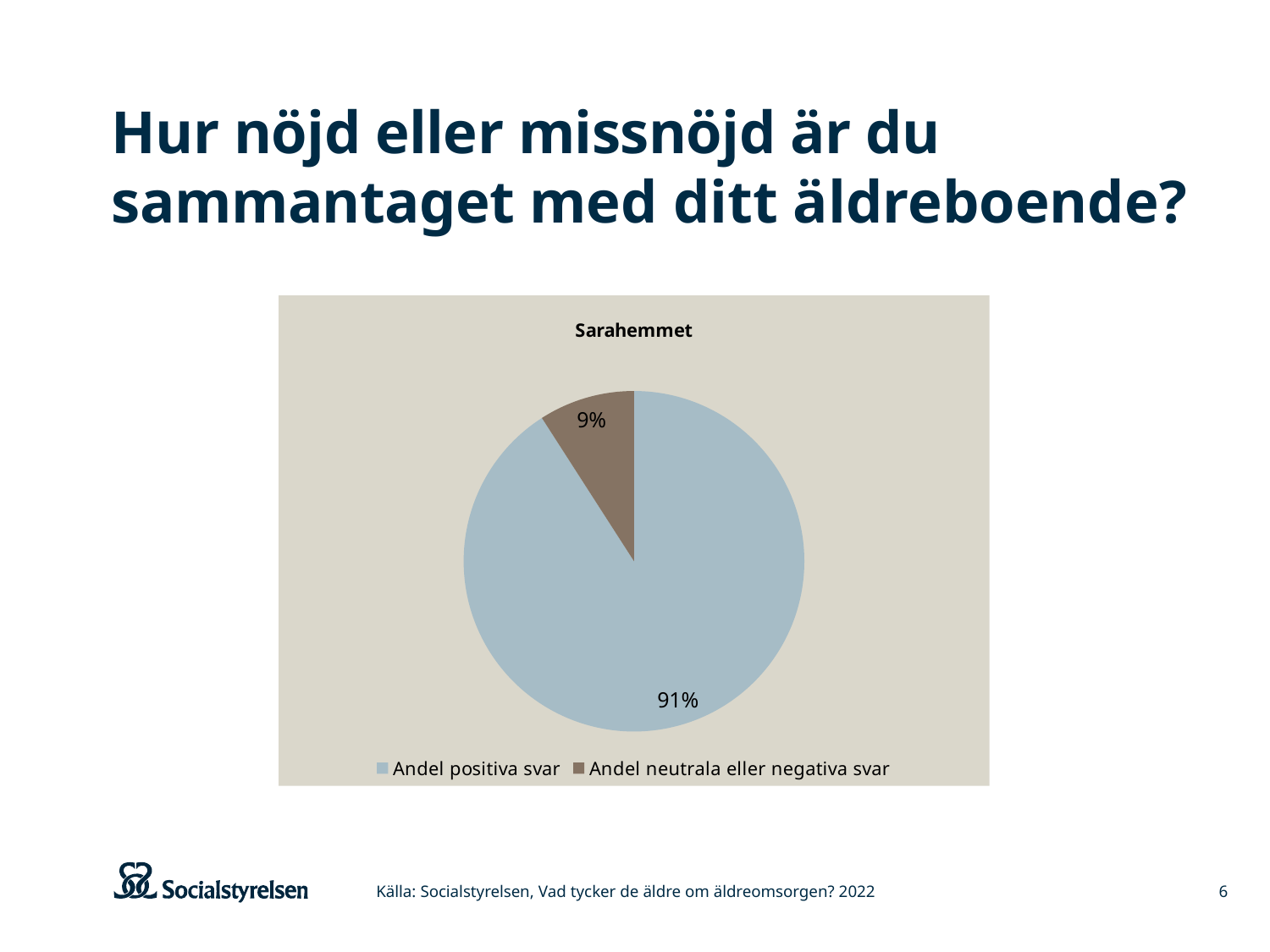
How many entries does the legend list? 2 Which is larger, 'Andel positiva svar' or 'Andel neutrala eller negativa svar'? Andel positiva svar Which legend entry is shown in brown? Andel neutrala eller negativa svar How many slices does the pie chart have? 2 What is the difference in percentage points between 'Andel positiva svar' and 'Andel neutrala eller negativa svar'? 82 What type of chart is shown on the slide? pie chart Which slice is the largest? Andel positiva svar What share of the pie is 'Andel positiva svar'? 91% What share of the pie is 'Andel neutrala eller negativa svar'? 9% What is the title of the chart? Sarahemmet Which slice is the smallest? Andel neutrala eller negativa svar